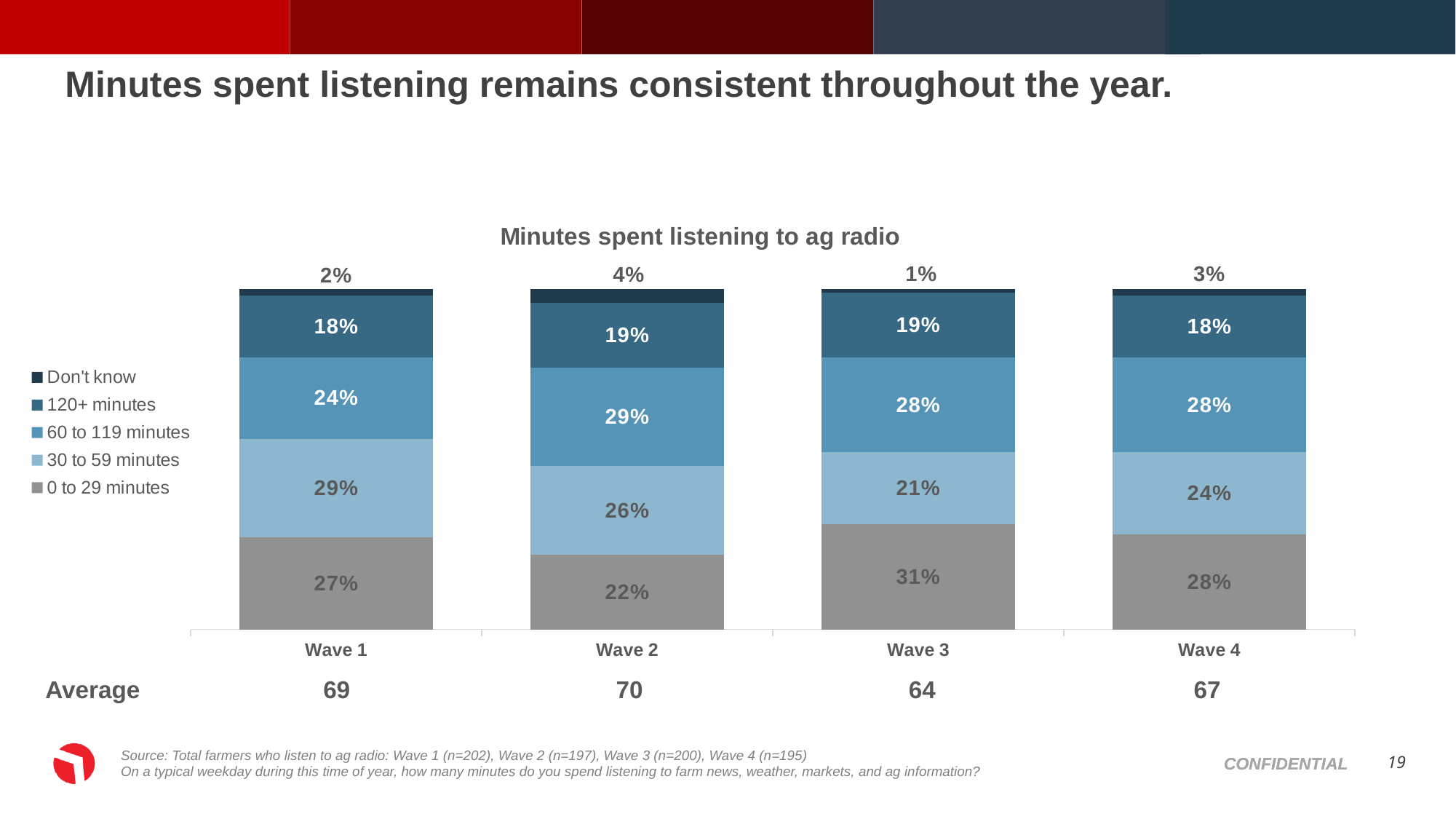
What is the difference between the 30 to 59 minutes values for Wave 1 and Wave 3? 8 percentage points Which is larger, the 60 to 119 minutes value for Wave 1 or for Wave 2? Wave 2 What is the title of the chart? Minutes spent listening to ag radio How many waves (categories) are shown on the x axis? 4 What kind of chart is shown on the slide? Stacked bar chart What is the value for Don't know in Wave 4? 3% What is the value for 0 to 29 minutes in Wave 3? 31% What is the total of the stacked bar for Wave 1? 100% Which wave has the highest share for 0 to 29 minutes? Wave 3 How many series does the legend list? 5 Which wave has the lowest share for Don't know? Wave 3 What is the value for 120+ minutes in Wave 2? 19%